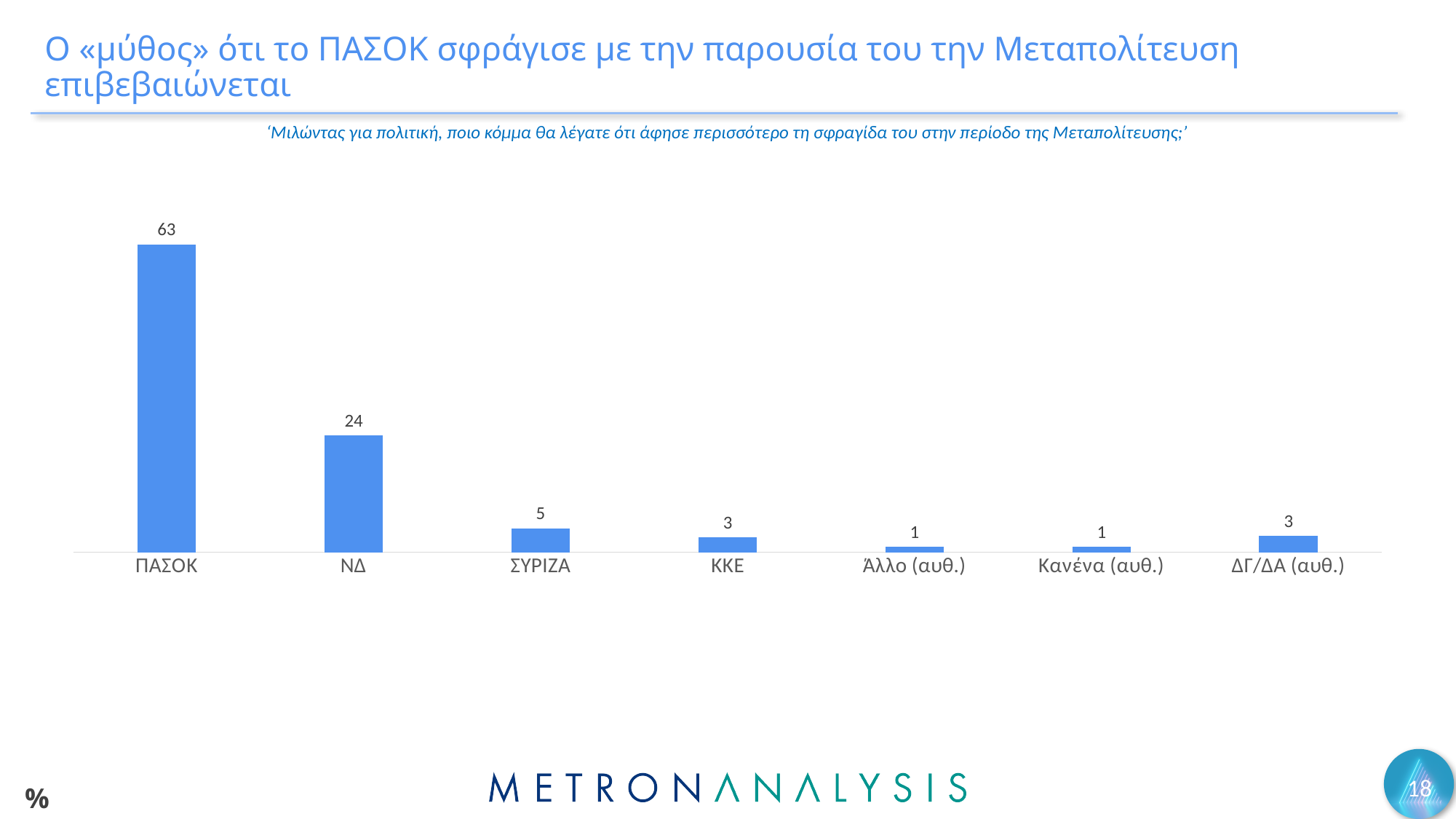
What is the value for ΝΔ? 24 How many categories are shown on the x axis? 7 What is the difference between the values for ΝΔ and ΣΥΡΙΖΑ? 19 What is the value for ΚΚΕ? 3 What is the value for ΠΑΣΟΚ? 63 What is the value for Κανένα (αυθ.)? 1 What is the difference between the values for ΠΑΣΟΚ and ΝΔ? 39 What is the value for ΣΥΡΙΖΑ? 5 Which category has the highest value? ΠΑΣΟΚ What is the value for ΔΓ/ΔΑ (αυθ.)? 3 Which is larger, the value for ΣΥΡΙΖΑ or the value for ΚΚΕ? ΣΥΡΙΖΑ What kind of chart is shown on the slide? Bar chart